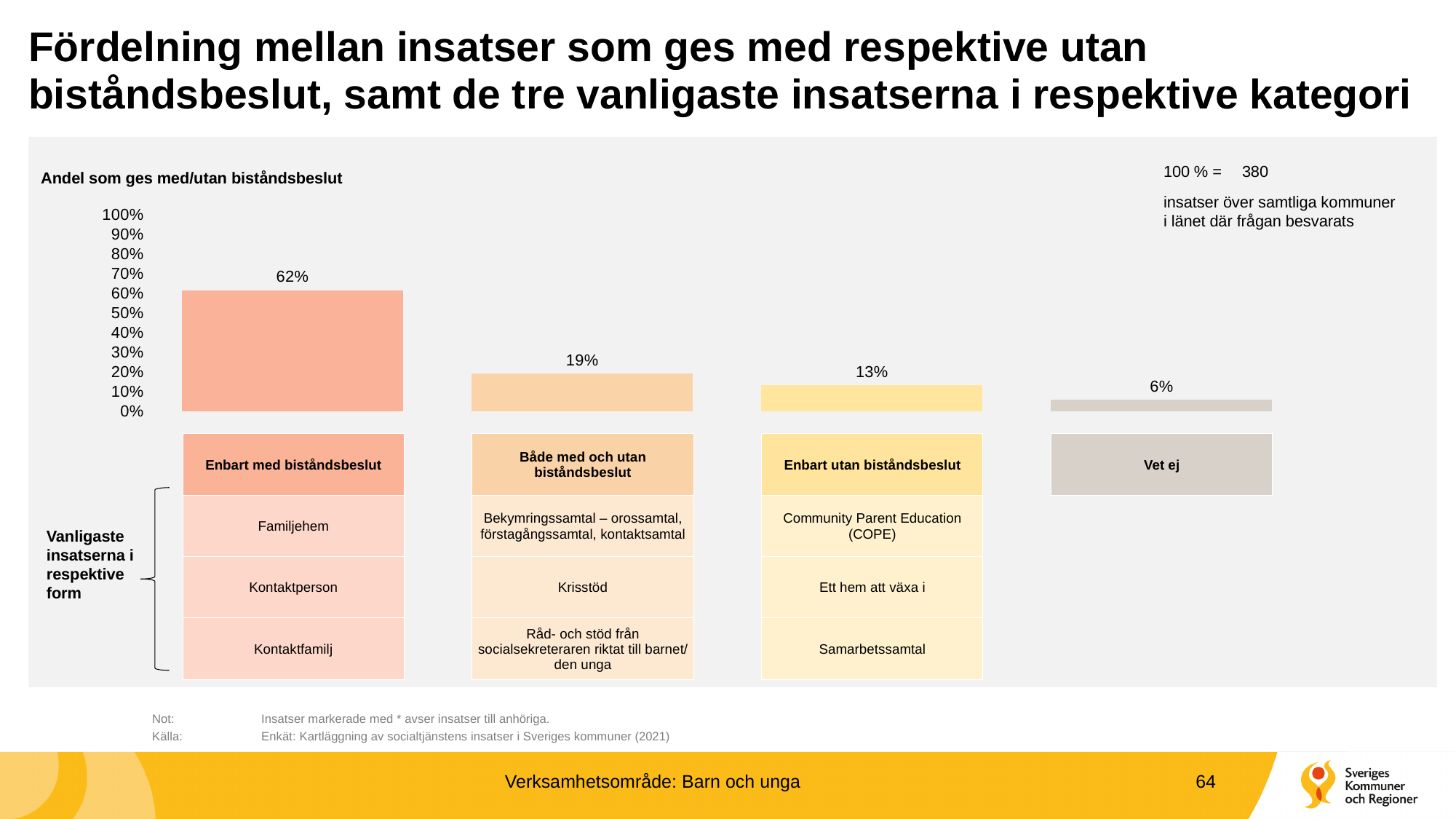
What kind of chart is this? Bar chart What is the title of the chart? Andel som ges med/utan biståndsbeslut What is the difference between "Enbart med biståndsbeslut" and "Både med och utan biståndsbeslut"? 43 percentage points What is the value for "Vet ej"? 6% How many categories are shown in the chart? 4 Which is larger, "Enbart utan biståndsbeslut" or "Vet ej"? Enbart utan biståndsbeslut What is the value for "Enbart med biståndsbeslut"? 62% Is the value for "Enbart med biståndsbeslut" greater or less than 50%? greater What is the value for "Enbart utan biståndsbeslut"? 13% Which category has the highest value? Enbart med biståndsbeslut What is the value for "Både med och utan biståndsbeslut"? 19% Which category has the lowest value? Vet ej